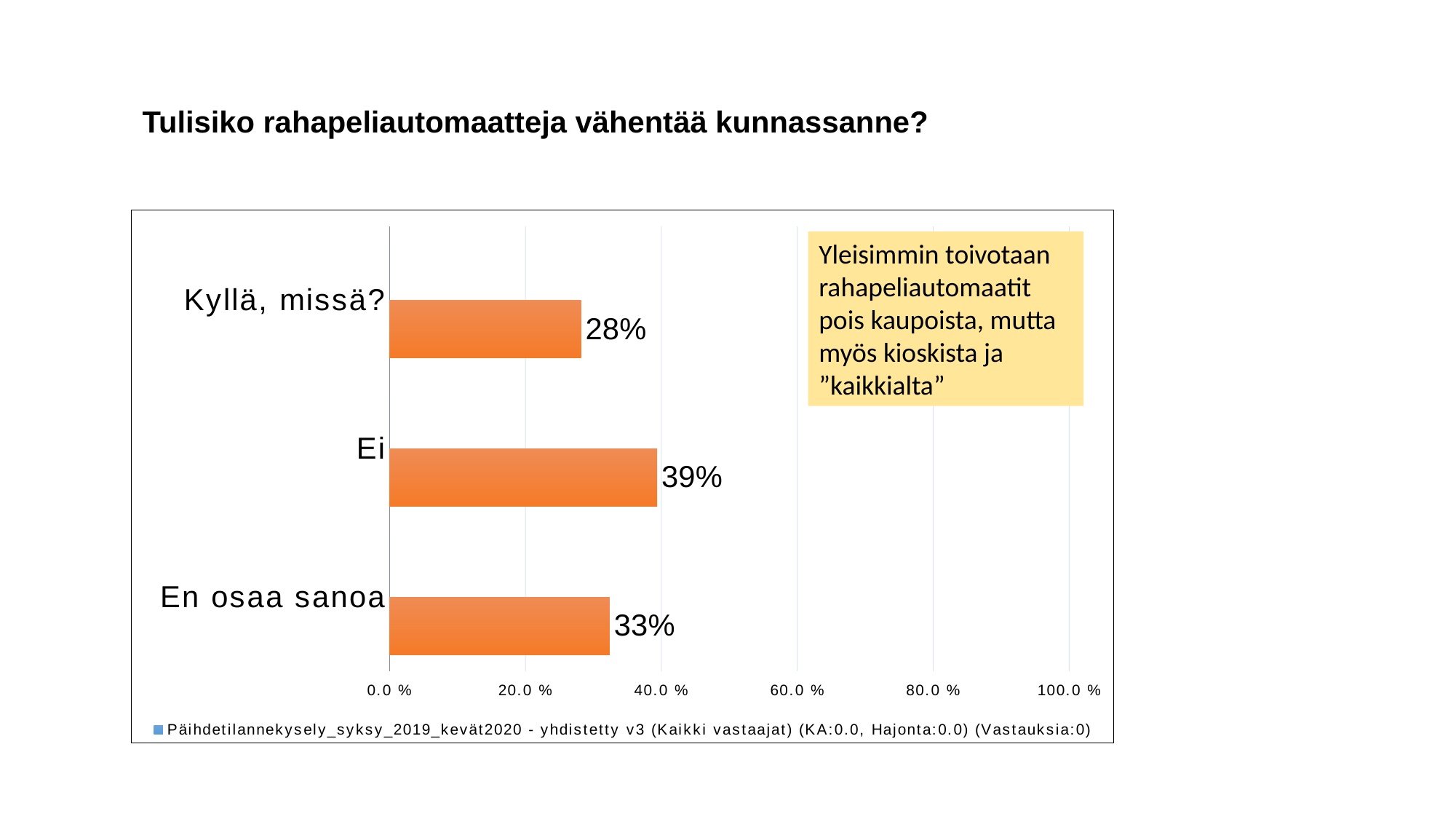
What is the value for "En osaa sanoa"? 33% Which category has the lowest value? Kyllä, missä? What is the value for "Kyllä, missä?"? 28% What is the value for "Ei"? 39% What is the title of the slide above the chart? Tulisiko rahapeliautomaatteja vähentää kunnassanne? What kind of chart is shown on the slide? bar chart Which category has the highest value? Ei What is the difference between the values for "Ei" and "Kyllä, missä?"? 11% Which is larger, the value for "En osaa sanoa" or the value for "Kyllä, missä?"? En osaa sanoa How many categories are shown in the chart? 3 Is the value for "Ei" greater or less than 40.0 %? less What is the difference between the values for "Ei" and "En osaa sanoa"? 6%